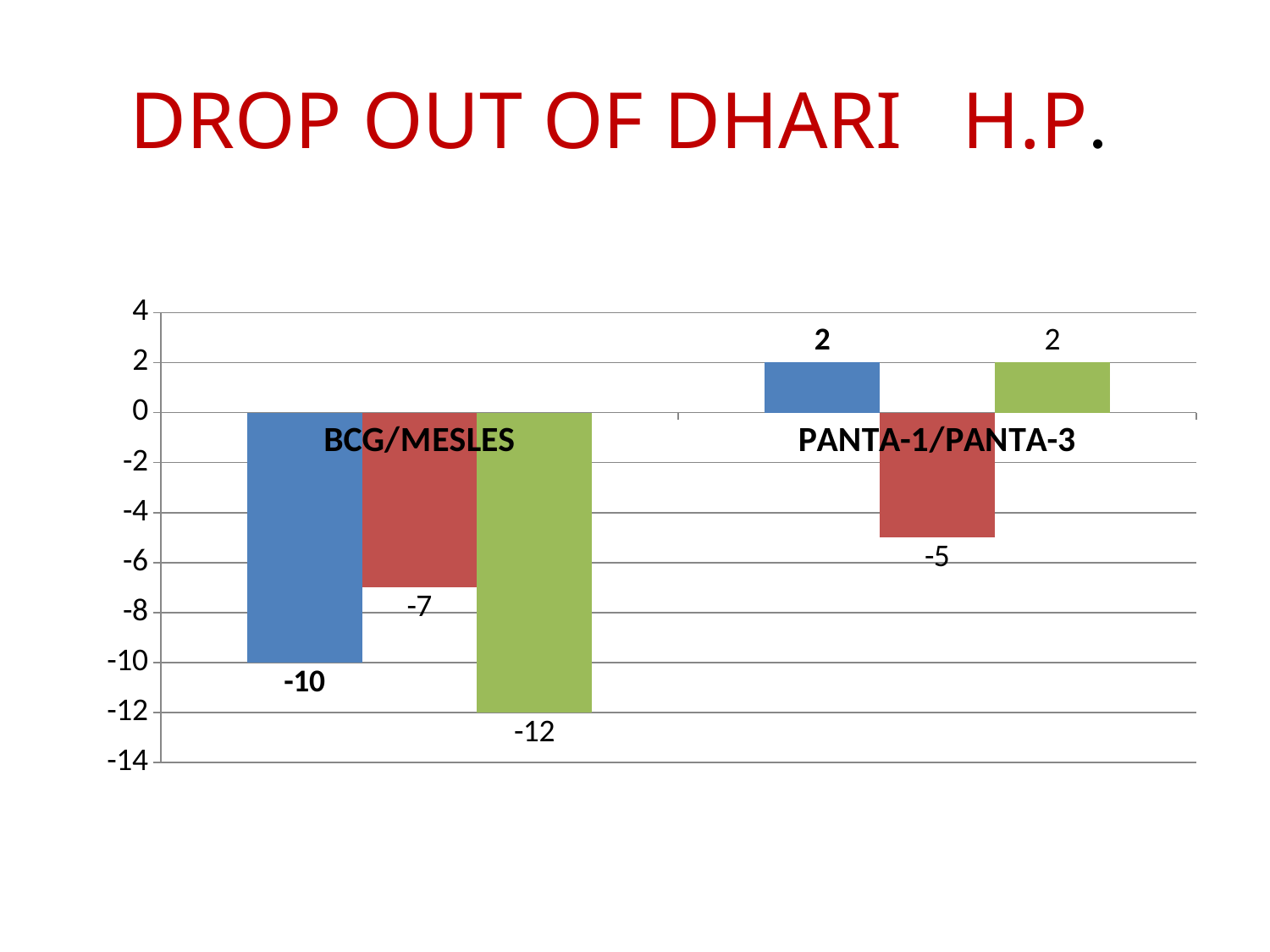
What is the value of the red bar for PANTA-1/PANTA-3? -5 What is the value of the blue bar for PANTA-1/PANTA-3? 2 What is the value of the green bar for BCG/MESLES? -12 What is the value of the red bar for BCG/MESLES? -7 Which is larger, the red bar for BCG/MESLES or the red bar for PANTA-1/PANTA-3? PANTA-1/PANTA-3 What is the value of the blue bar for BCG/MESLES? -10 What type of chart is shown on the slide? bar chart How many categories are shown on the x axis of the chart? 2 Which bar has the lowest value in the chart? the green bar for BCG/MESLES (-12) How many bars are plotted for each category? 3 What is the title of the slide containing the chart? DROP OUT OF DHARI H.P. What is the difference between the green bar and the red bar for BCG/MESLES? 5